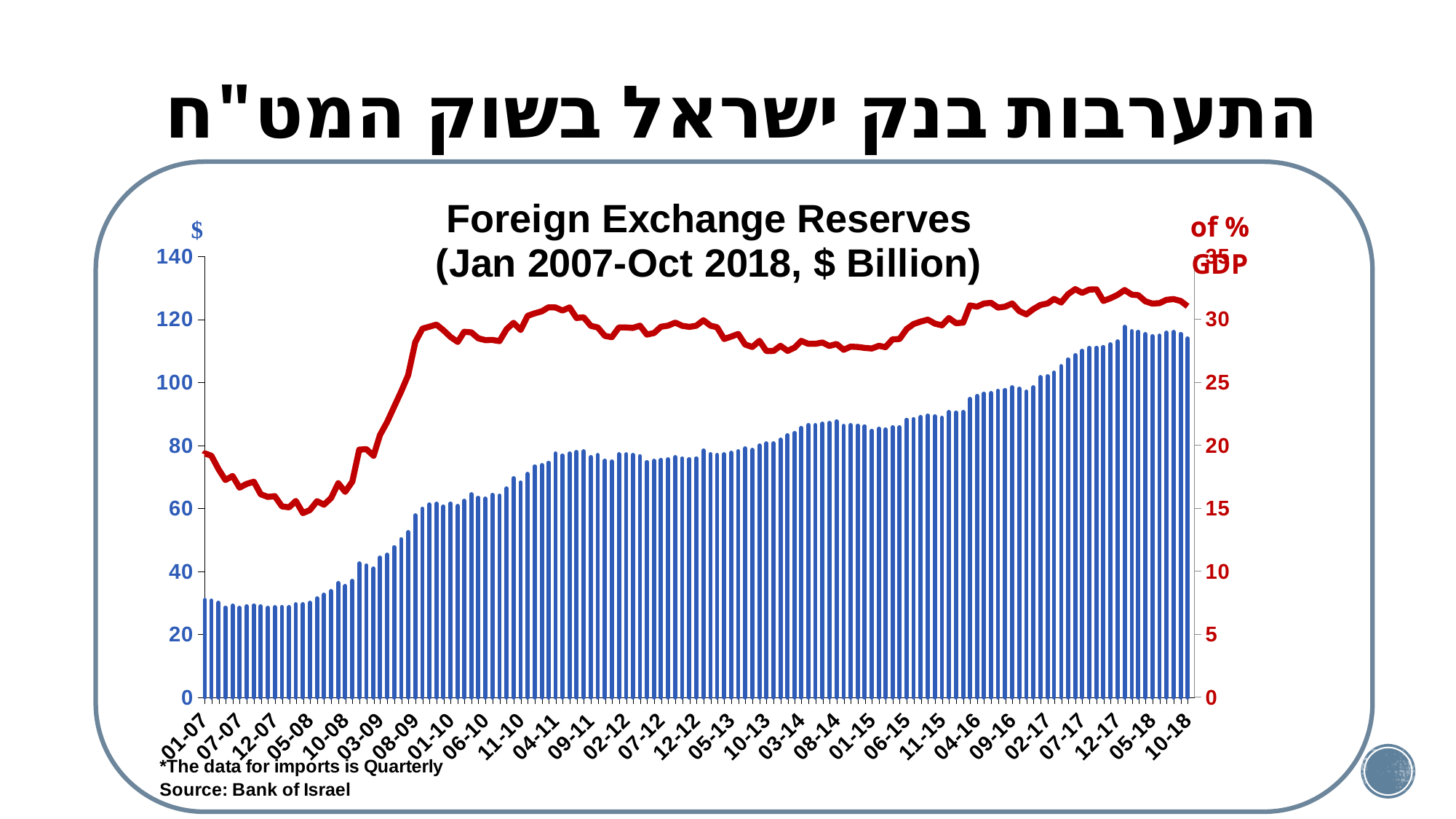
What is the source of the data cited on the slide? Bank of Israel Is the value of the blue bar for 10-18 greater or less than 100? greater Do the blue bars generally rise or fall from 01-07 to 10-18? rise What kind of chart is shown on the slide? A bar chart combined with a line chart What is the title of the chart? Foreign Exchange Reserves (Jan 2007-Oct 2018, $ Billion) Which is larger, the blue bar for 01-07 or the blue bar for 10-18? 10-18 Is the value of the blue bar for 01-07 greater or less than 40? less Is the red line's value (% of GDP) at 01-10 greater or less than 25? greater Does the red line rise or fall between 01-07 and 05-08? fall